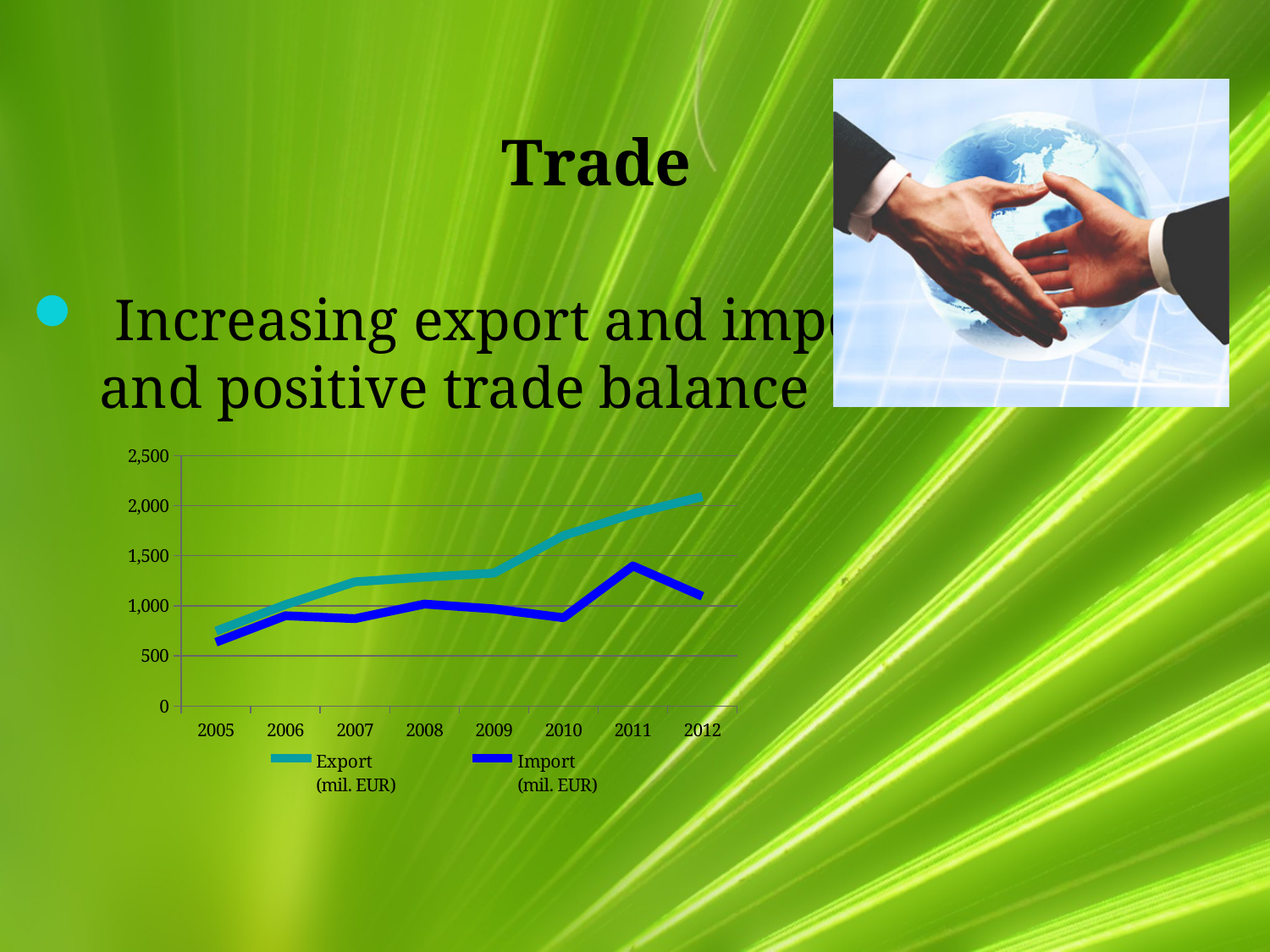
Is the Export (mil. EUR) value for 2010 greater or less than 1,500? greater How many years are plotted along the x axis of the chart? 8 In which year is the Export (mil. EUR) value lowest? 2005 Is the Import (mil. EUR) value for 2011 greater or less than 1,500? less In which year is the Import (mil. EUR) value highest? 2011 In 2012, which is larger, Export (mil. EUR) or Import (mil. EUR)? Export (mil. EUR) What kind of chart is shown on the slide? line chart How many series does the chart's legend list? 2 Is the Export (mil. EUR) value for 2012 greater or less than 2,000? greater Does the Export (mil. EUR) series rise or fall from 2005 to 2012? rise In which year is the Export (mil. EUR) value highest? 2012